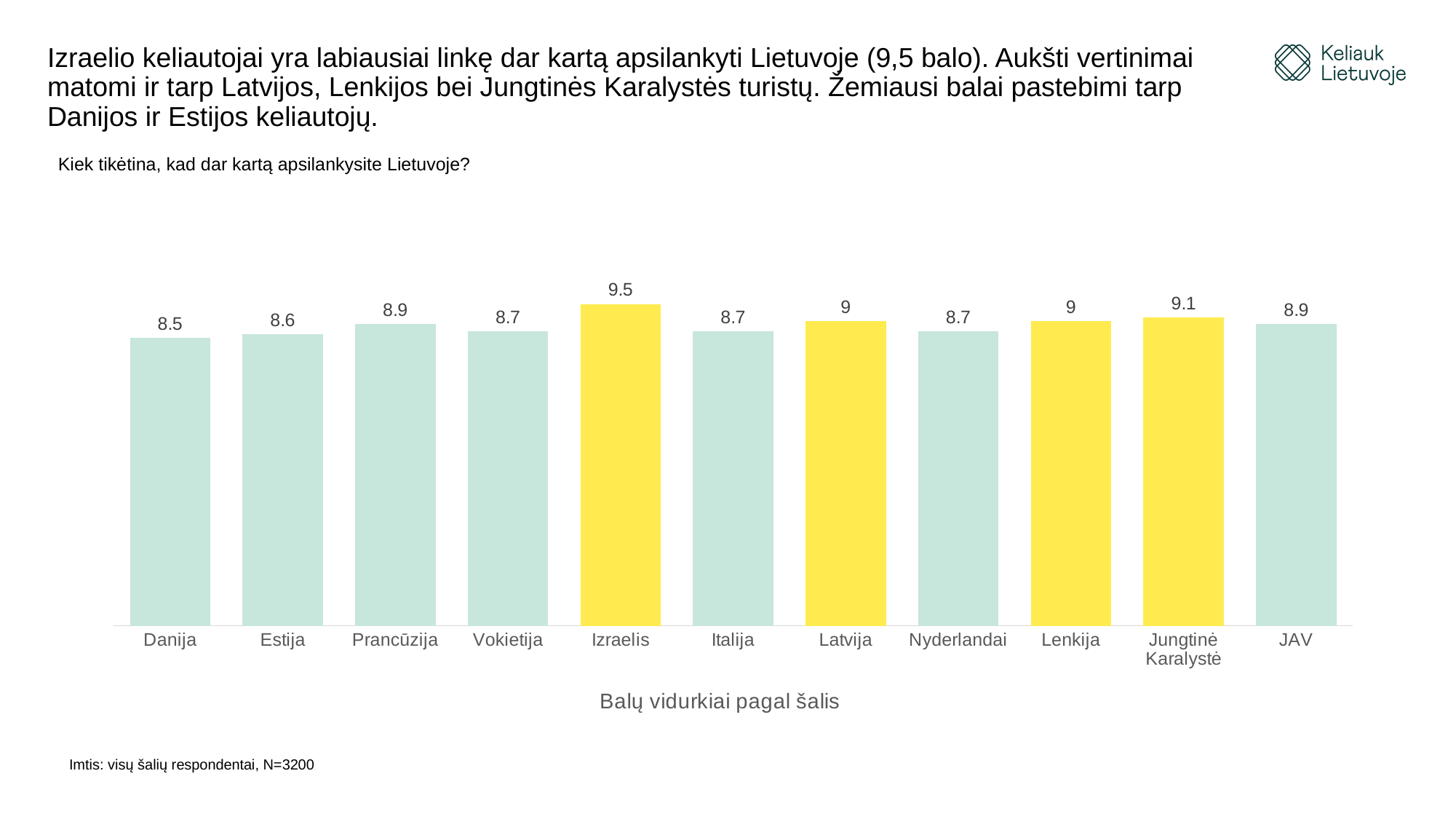
What is the difference between the values for Jungtinė Karalystė and Estija? 0.5 How many bars are highlighted in yellow? 4 What is the value for Nyderlandai? 8.7 Which country has the highest value? Izraelis What kind of chart is shown on the slide? bar chart Which is larger, the value for Prancūzija or the value for Vokietija? Prancūzija What is the difference between the values for Izraelis and Danija? 1 What is the value for Danija? 8.5 Which country has the lowest value? Danija What is the value for Jungtinė Karalystė? 9.1 What is the value for Izraelis? 9.5 How many countries are shown in the chart? 11